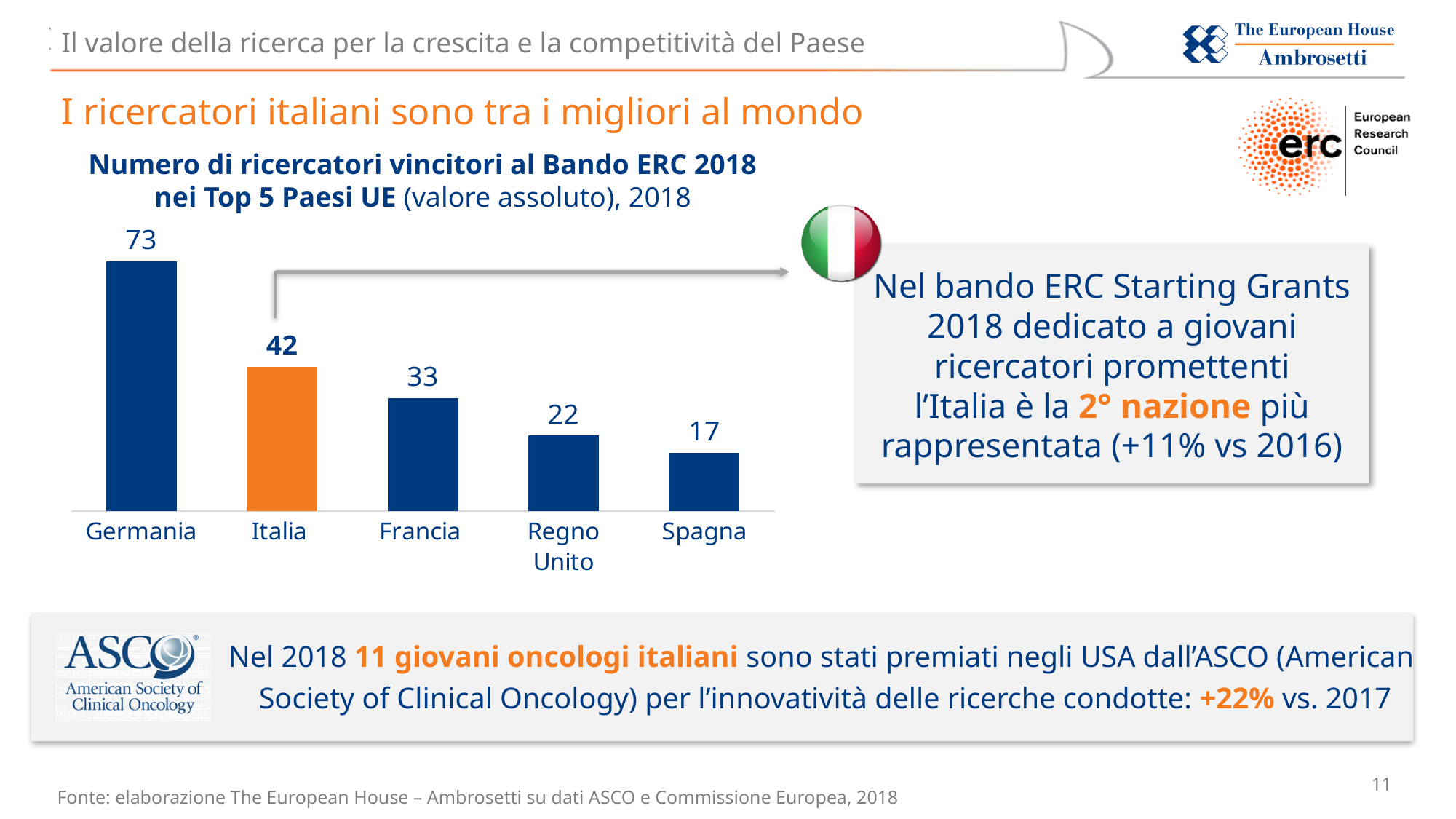
What is the difference between the values for Francia and Spagna? 16 How many countries are shown in the chart? 5 Which country has the highest number of ERC 2018 winners? Germania What is the value for Germania? 73 Which country has the lowest number of ERC 2018 winners? Spagna What is the value for Francia? 33 What is the value for Regno Unito? 22 Which bar is highlighted in orange? Italia What kind of chart is shown on the slide? Bar chart What is the value for Italia? 42 What is the difference between the values for Germania and Italia? 31 Which is larger, the value for Italia or the value for Francia? Italia